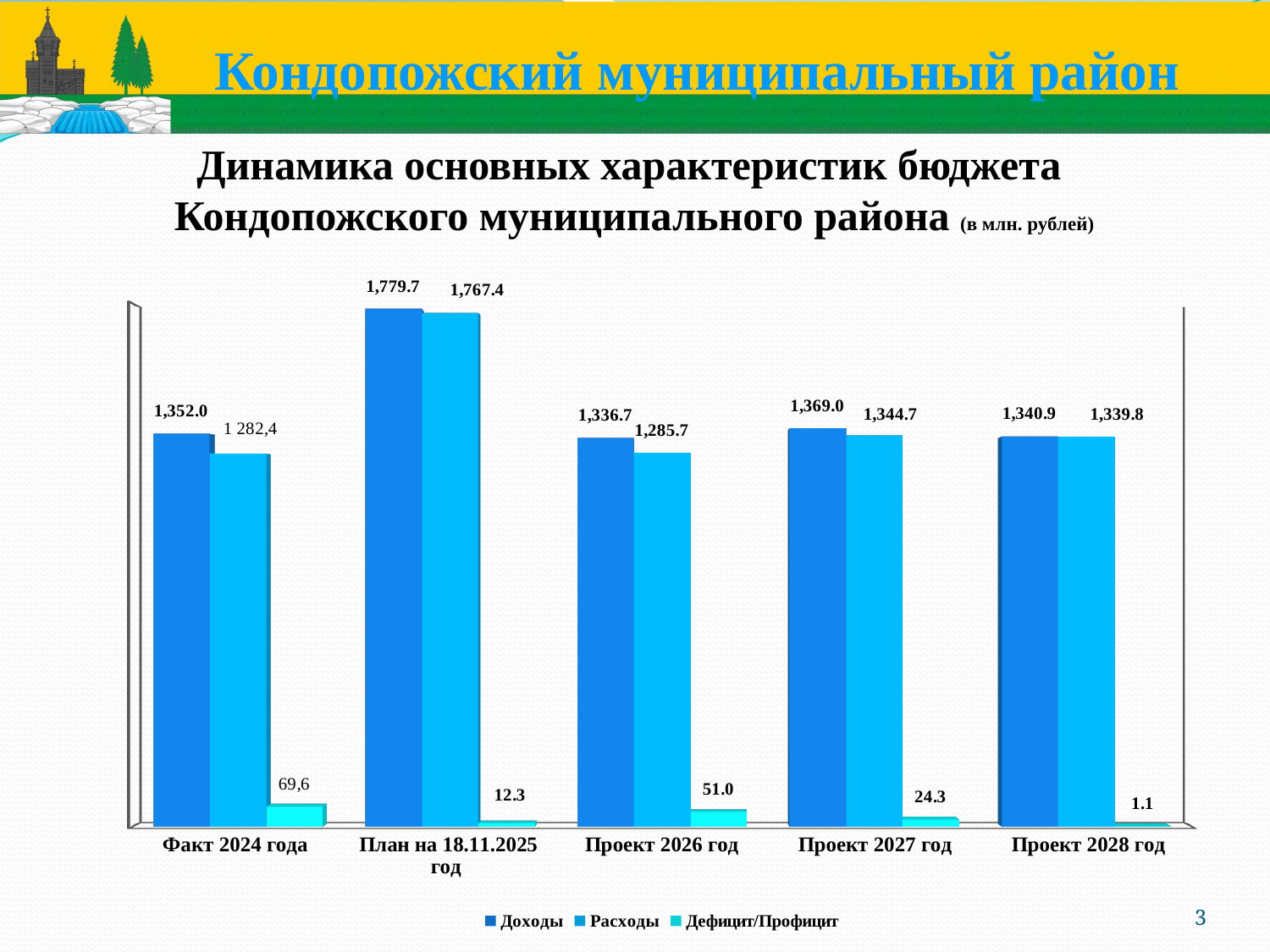
What kind of chart is shown on the slide? Bar chart What is the value of Дефицит/Профицит for Проект 2026 год? 51.0 Which category has the highest value of Доходы? План на 18.11.2025 год What is the value of Доходы for Факт 2024 года? 1,352.0 What is the difference between Доходы and Расходы for Проект 2027 год? 24.3 What is the value of Расходы for Проект 2028 год? 1,339.8 Which category has the lowest value of Дефицит/Профицит? Проект 2028 год How many categories are shown on the x axis? 5 What is the difference between Доходы for План на 18.11.2025 год and Доходы for Проект 2026 год? 443.0 What is the value of Расходы for План на 18.11.2025 год? 1,767.4 Which is larger: Доходы for Проект 2027 год or Доходы for Проект 2028 год? Проект 2027 год How many series does the legend list? 3